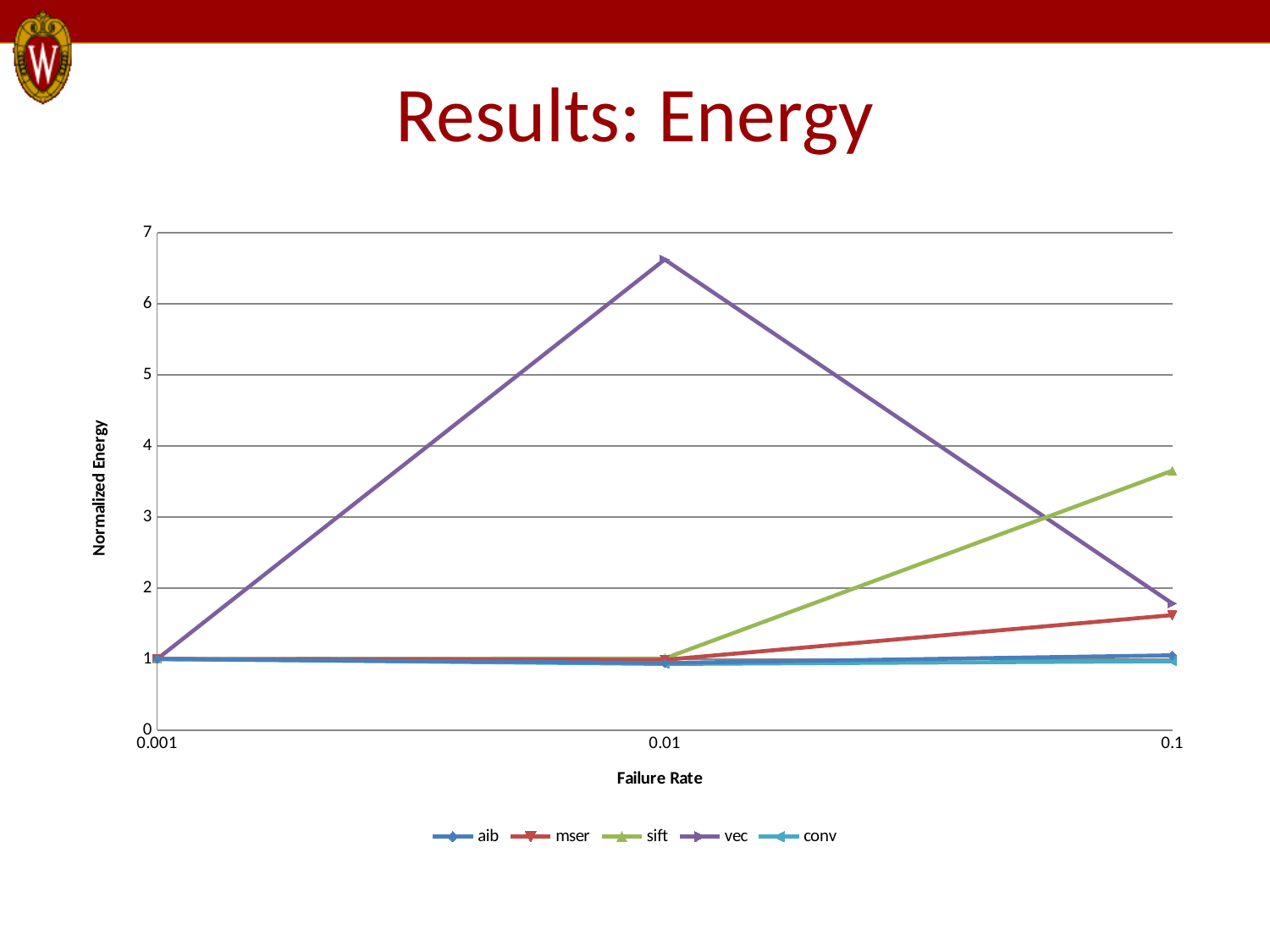
Is the value for vec at a failure rate of 0.01 greater or less than 6? greater Is the value for sift at a failure rate of 0.1 greater or less than 3? greater Is the value for mser at a failure rate of 0.1 greater or less than 2? less Does the sift series rise or fall between failure rates 0.01 and 0.1? rise At a failure rate of 0.1, which series has the larger value, sift or mser? sift What kind of chart is shown on the slide? line chart How many failure rate values are plotted along the x axis? 3 Does the vec series rise or fall between failure rates 0.01 and 0.1? fall Which series has the highest normalized energy at a failure rate of 0.01? vec How many series does the legend list? 5 What is the label of the y axis? Normalized Energy Which series has the highest normalized energy at a failure rate of 0.1? sift